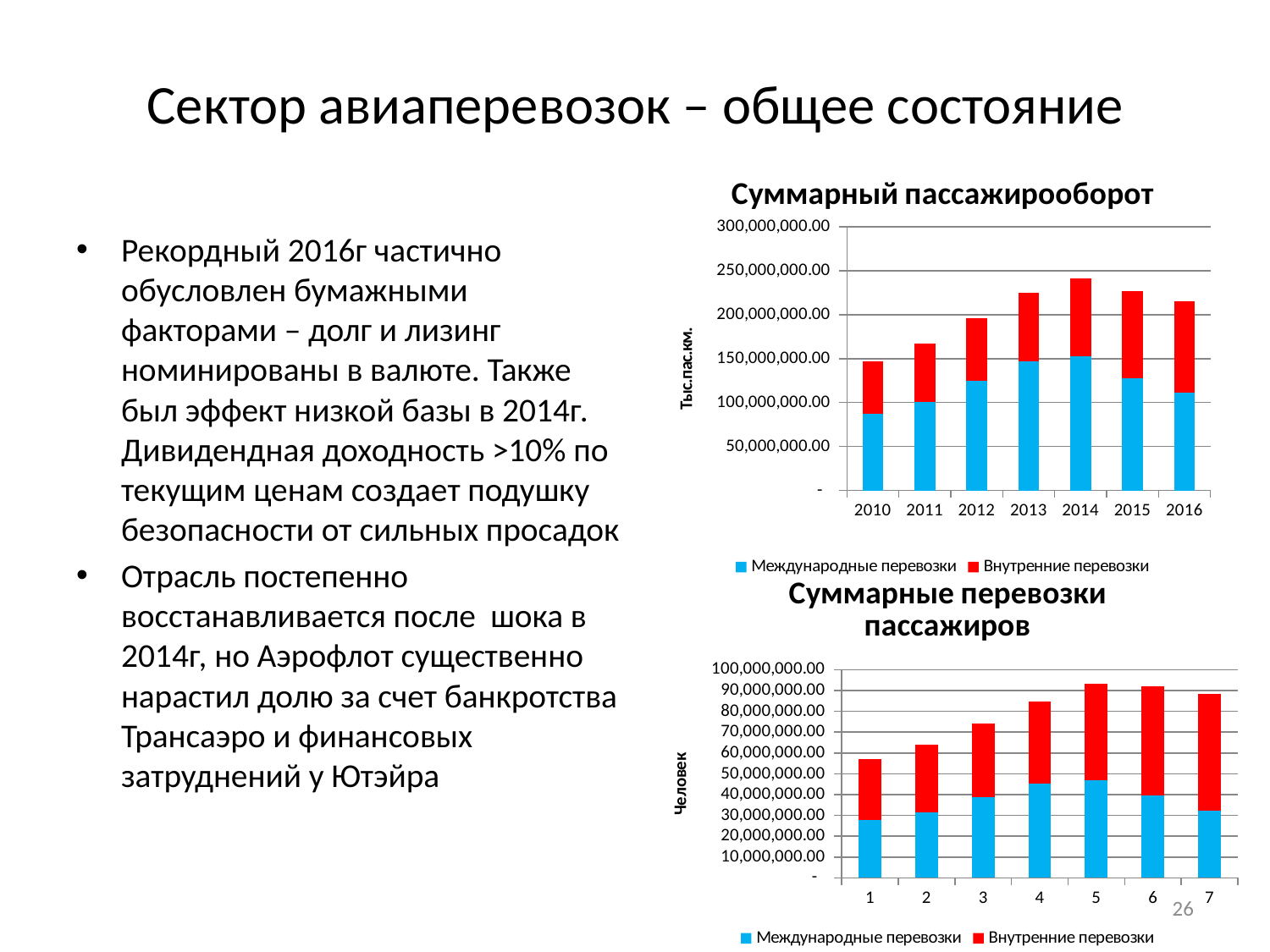
In the 'Суммарный пассажирооборот' chart, which year has the lowest total bar? 2010 In the 'Суммарный пассажирооборот' chart, is the total for 2014 greater or less than 200,000,000.00? greater In the 'Суммарные перевозки пассажиров' chart, is the total for category 5 greater or less than 90,000,000.00? greater How many series does the legend of the 'Суммарный пассажирооборот' chart list? 2 In the 'Суммарные перевозки пассажиров' chart, which colour represents 'Внутренние перевозки'? red In the 'Суммарный пассажирооборот' chart, which year has the highest total bar? 2014 What kind of chart is the 'Суммарный пассажирооборот' chart? stacked bar chart In the 'Суммарные перевозки пассажиров' chart, which category has the lowest total bar? 1 What is the y-axis unit label on the 'Суммарные перевозки пассажиров' chart? Человек In the 'Суммарный пассажирооборот' chart, which is larger: the total for 2013 or the total for 2011? 2013 How many years are shown on the x axis of the 'Суммарный пассажирооборот' chart? 7